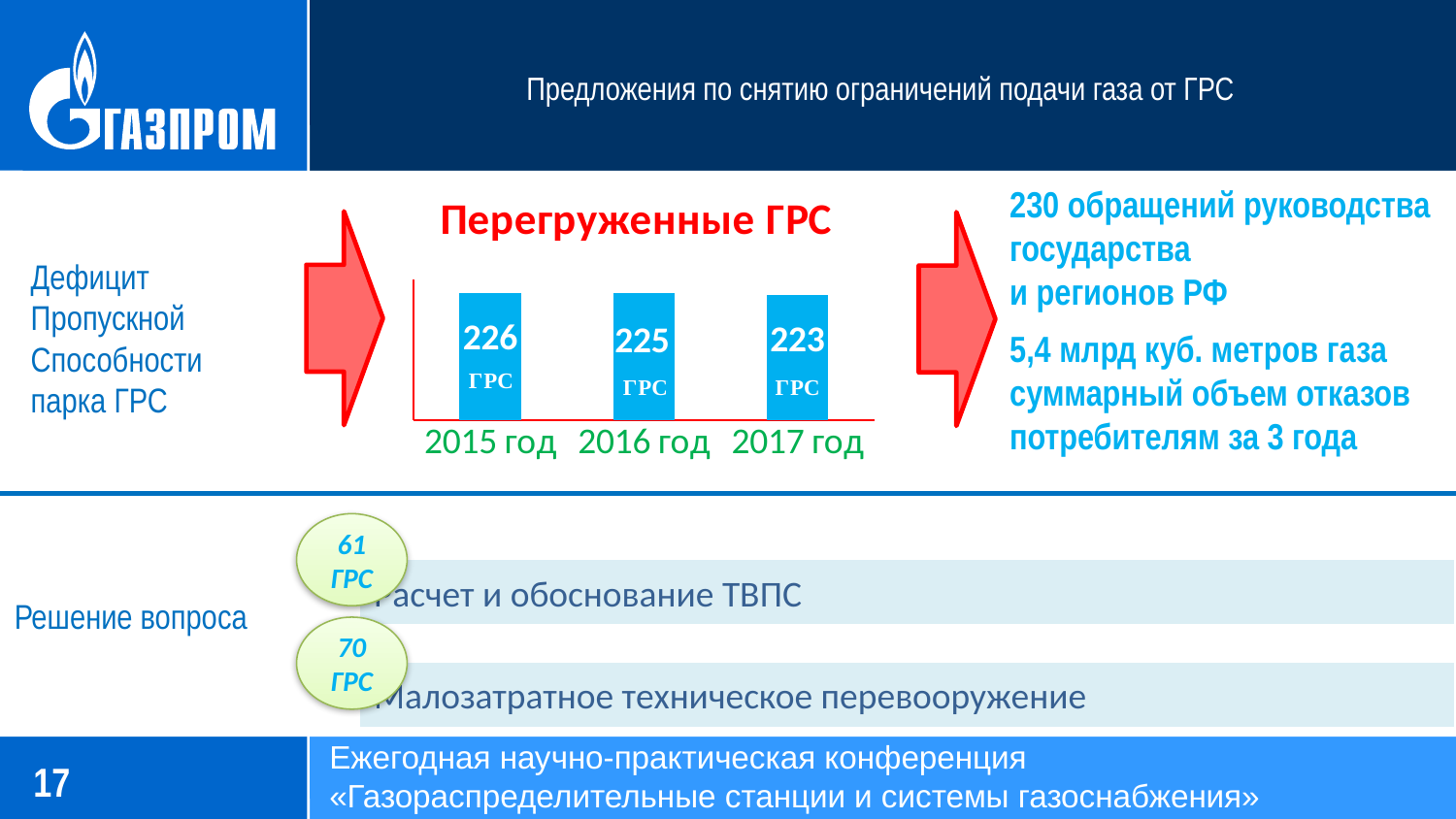
Which year has the lowest value in the chart "Перегруженные ГРС"? 2017 год Do the values in the chart "Перегруженные ГРС" rise or fall from 2015 год to 2017 год? fall What is the title of the chart on the slide? Перегруженные ГРС What type of chart is shown under the title "Перегруженные ГРС"? bar chart What is the difference between the values for 2015 год and 2017 год in the chart "Перегруженные ГРС"? 3 What is the value shown for 2017 год in the chart "Перегруженные ГРС"? 223 ГРС Which year has the highest value in the chart "Перегруженные ГРС"? 2015 год What is the difference between the values for 2016 год and 2017 год in the chart "Перегруженные ГРС"? 2 How many bars (years) does the chart "Перегруженные ГРС" show? 3 In the chart "Перегруженные ГРС", which is larger: the value for 2015 год or for 2016 год? 2015 год What is the value shown for 2016 год in the chart "Перегруженные ГРС"? 225 ГРС What is the value shown for 2015 год in the chart "Перегруженные ГРС"? 226 ГРС